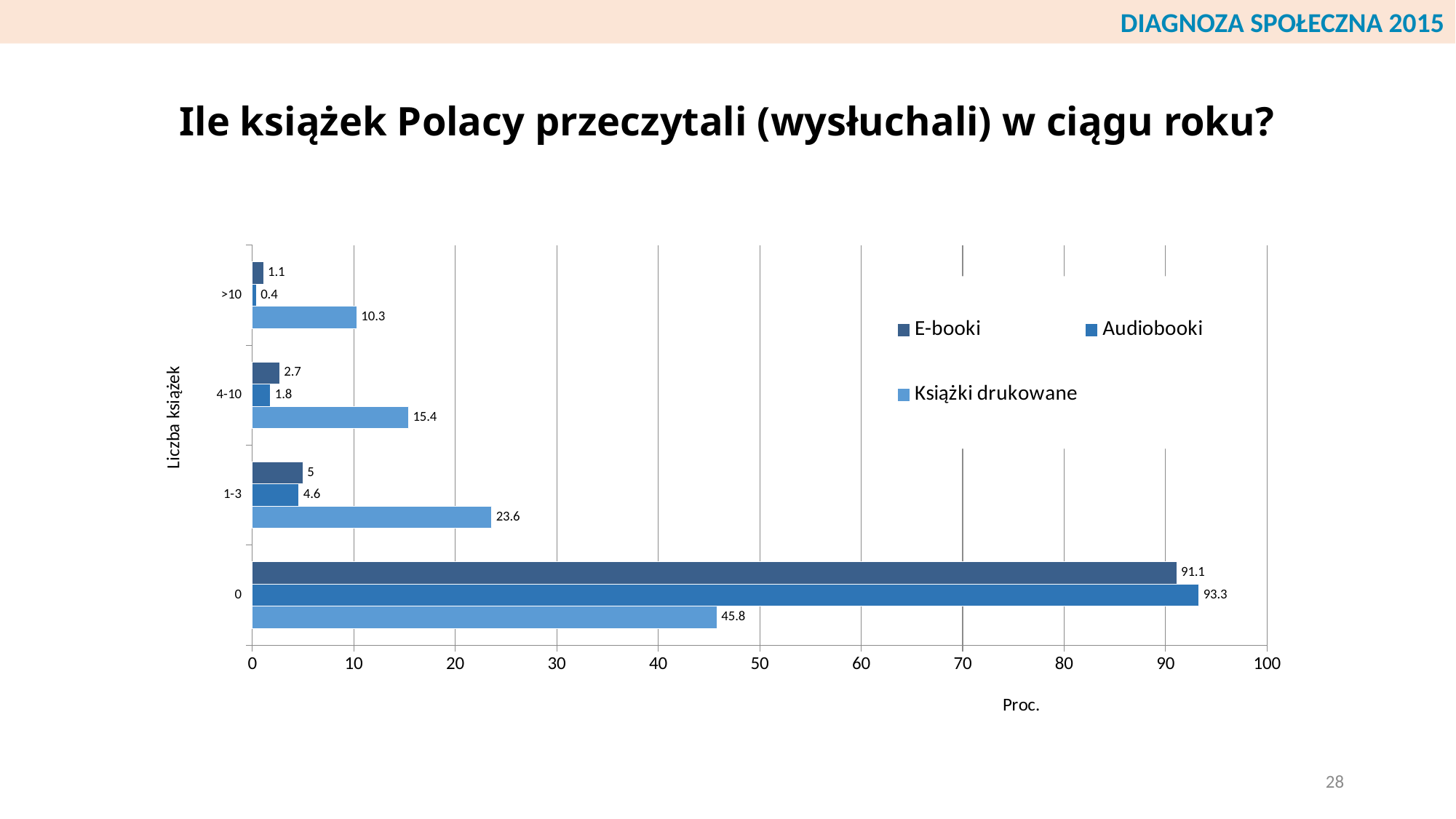
What is the value for Książki drukowane in the 0 category? 45.8 Which category has the highest value for Audiobooki? 0 How many series does the legend list? 3 What kind of chart is shown on the slide? bar chart Which is larger in the 1-3 category: E-booki or Książki drukowane? Książki drukowane Which category has the lowest value for Książki drukowane? >10 What is the difference between the Audiobooki and E-booki values in the 0 category? 2.2 Is the value for Książki drukowane in the 4-10 category greater or less than 20? less What is the value for E-booki in the 4-10 category? 2.7 What is the value for Książki drukowane in the >10 category? 10.3 How many categories are shown on the y axis? 4 What is the value for Audiobooki in the 1-3 category? 4.6